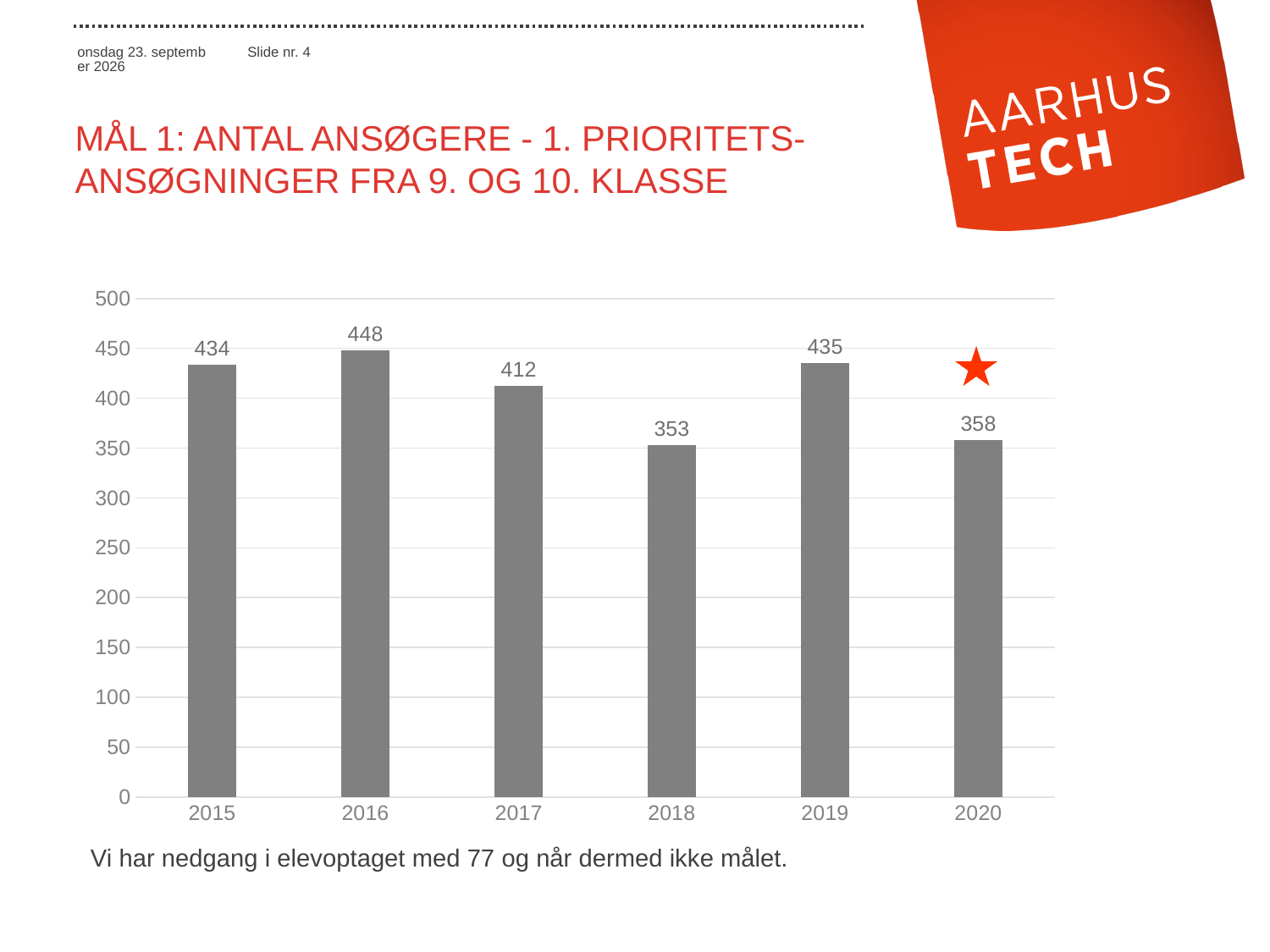
What is the difference between the values for 2019 and 2020? 77 How many years are shown on the x axis? 6 Which year has the highest value? 2016 Which is larger, the value for 2015 or the value for 2017? 2015 What is the value for 2018? 353 Do the values rise or fall from 2019 to 2020? Fall What is the difference between the values for 2016 and 2017? 36 What kind of chart is shown on the slide? Bar chart Which year's bar has a red star above it? 2020 What is the value for 2020? 358 What is the value for 2016? 448 Which year has the lowest value? 2018